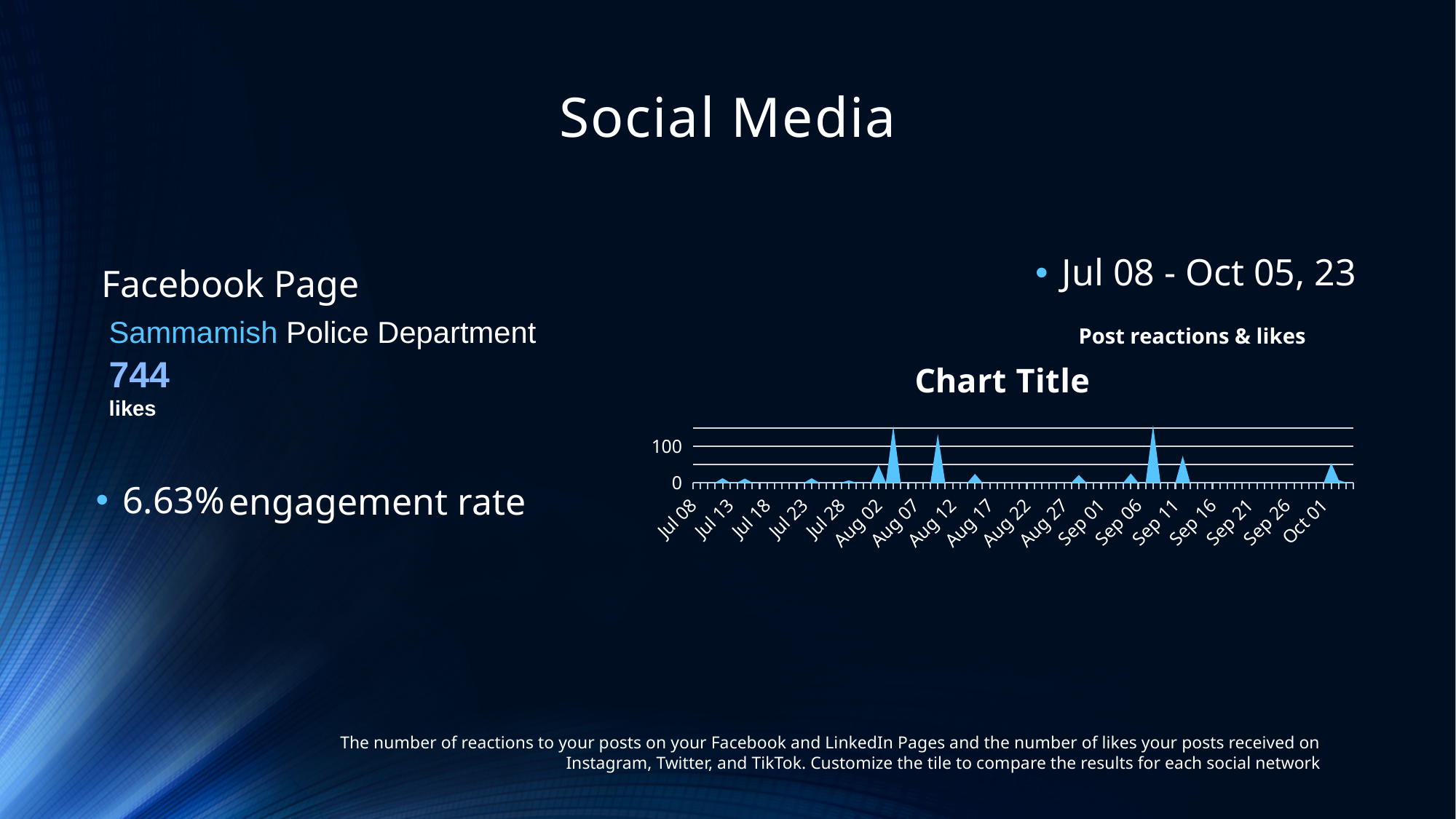
Which is larger, the value around Jul 13 or the peak around Aug 07? Aug 07 Is the value around Aug 22 greater or less than 100? less Is the value at Jul 08 greater or less than 100? less Is the peak value around Aug 12 greater or less than 100? greater What is the title of the chart? Chart Title Which is larger, the peak around Aug 07 or the peak around Aug 12? Aug 07 Which is larger, the peak around Sep 11 or the peak around Sep 16? Sep 11 What is the first date label on the x axis of the chart? Jul 08 How many date labels are shown on the x axis of the chart? 18 What kind of chart is shown on the slide? area chart